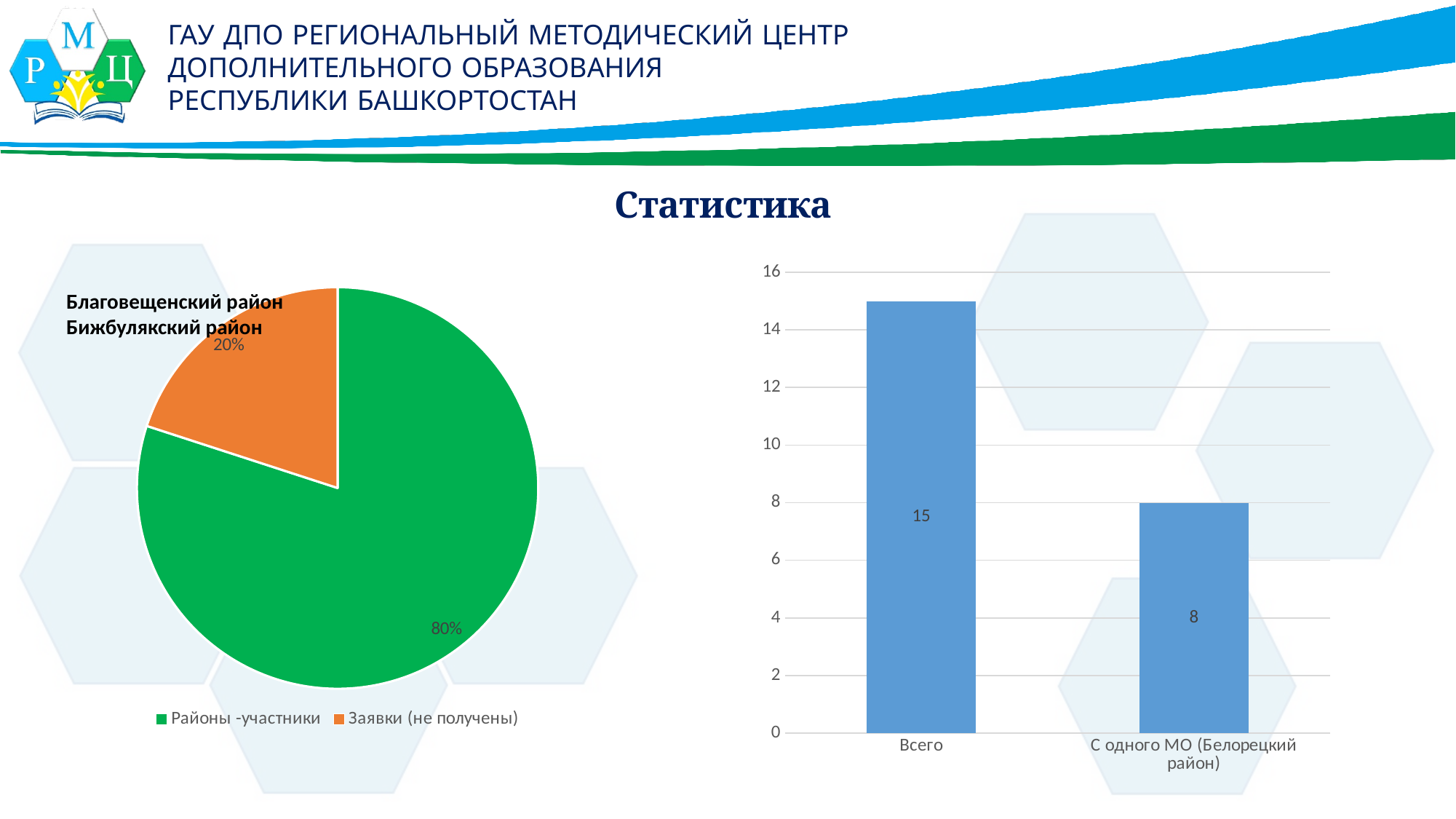
How many entries does the legend of the pie chart on the left list? 2 How many bars are shown in the bar chart on the right? 2 In the bar chart on the right, what is the value for 'С одного МО (Белорецкий район)'? 8 In the pie chart on the left, which slice is the largest? Районы -участники In the pie chart on the left, what share does the slice 'Районы -участники' have? 80% What kind of chart is the chart on the left of the slide? pie chart What kind of chart is the chart on the right of the slide? bar chart In the bar chart on the right, what is the difference between the values for 'Всего' and 'С одного МО (Белорецкий район)'? 7 In the pie chart on the left, what share does the slice 'Заявки (не получены)' have? 20% In the bar chart on the right, what is the value for 'Всего'? 15 In the pie chart on the left, which slice is the smallest? Заявки (не получены) In the pie chart on the left, what colour is the slice 'Заявки (не получены)'? orange